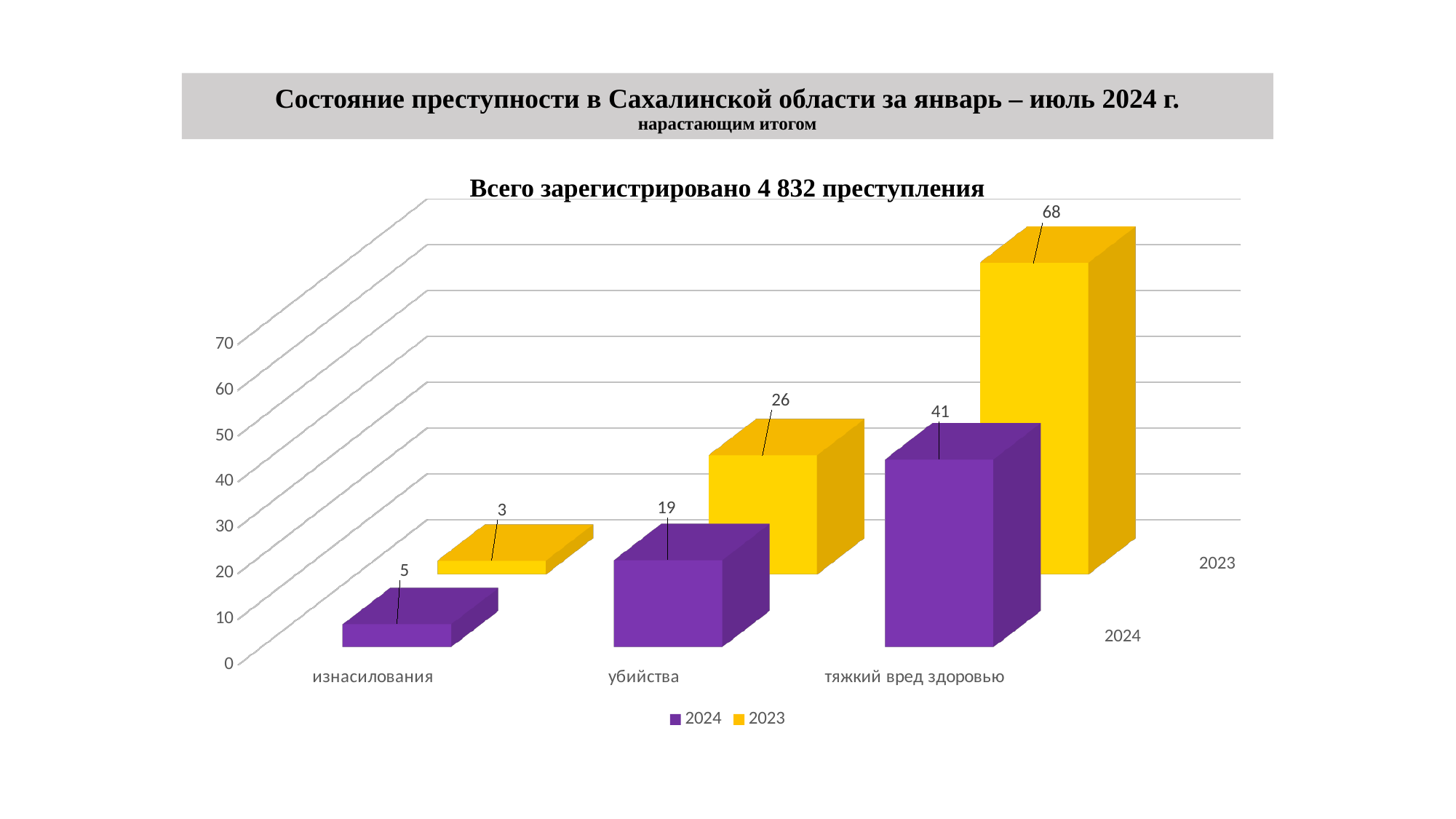
What is the value for изнасилования in the 2024 series? 5 What is the value for тяжкий вред здоровью in the 2024 series? 41 For изнасилования, which series has the larger value, 2024 or 2023? 2024 Which category has the highest value in the 2023 series? тяжкий вред здоровью What kind of chart is shown on the slide? bar chart How many categories are shown on the x axis? 3 How many series does the legend list? 2 What is the value for убийства in the 2023 series? 26 What is the value for изнасилования in the 2023 series? 3 Which category has the lowest value in the 2024 series? изнасилования What is the difference between the 2023 and 2024 values for убийства? 7 What is the difference between the 2023 and 2024 values for тяжкий вред здоровью? 27